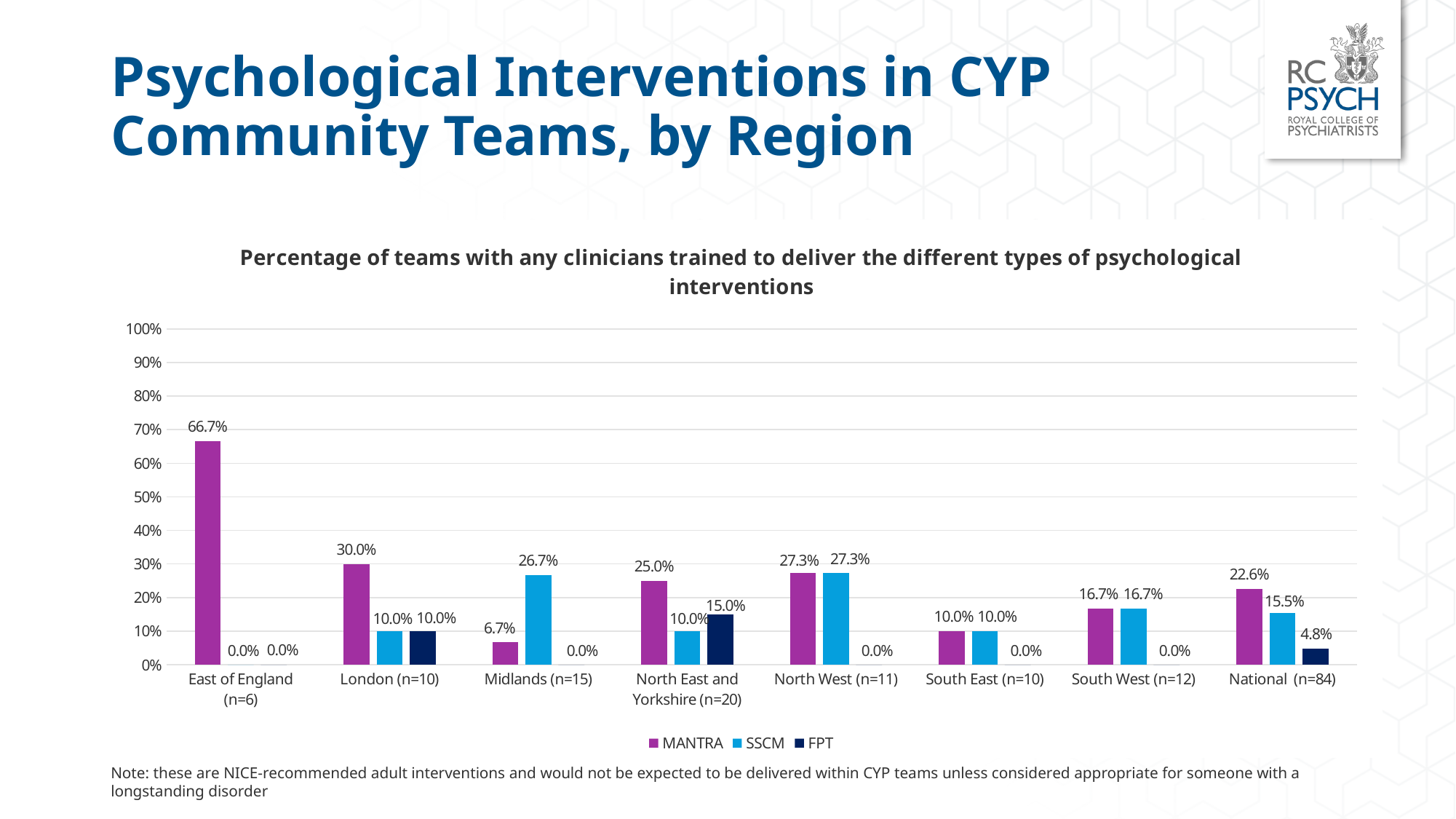
Which region has the highest MANTRA value? East of England (n=6) How many series does the legend list? 3 What is the difference between the MANTRA value for London (n=10) and the MANTRA value for National (n=84)? 7.4% What is the FPT value for National (n=84)? 4.8% How many regions (categories) are shown on the x axis? 8 Which region has the lowest MANTRA value? Midlands (n=15) What is the SSCM value for Midlands (n=15)? 26.7% Which is larger, the SSCM value for North West (n=11) or the SSCM value for South West (n=12)? North West (n=11) What is the MANTRA value for East of England (n=6)? 66.7% What kind of chart is shown on the slide? Bar chart What is the FPT value for North East and Yorkshire (n=20)? 15.0% Is the MANTRA value for East of England (n=6) greater or less than 60%? greater